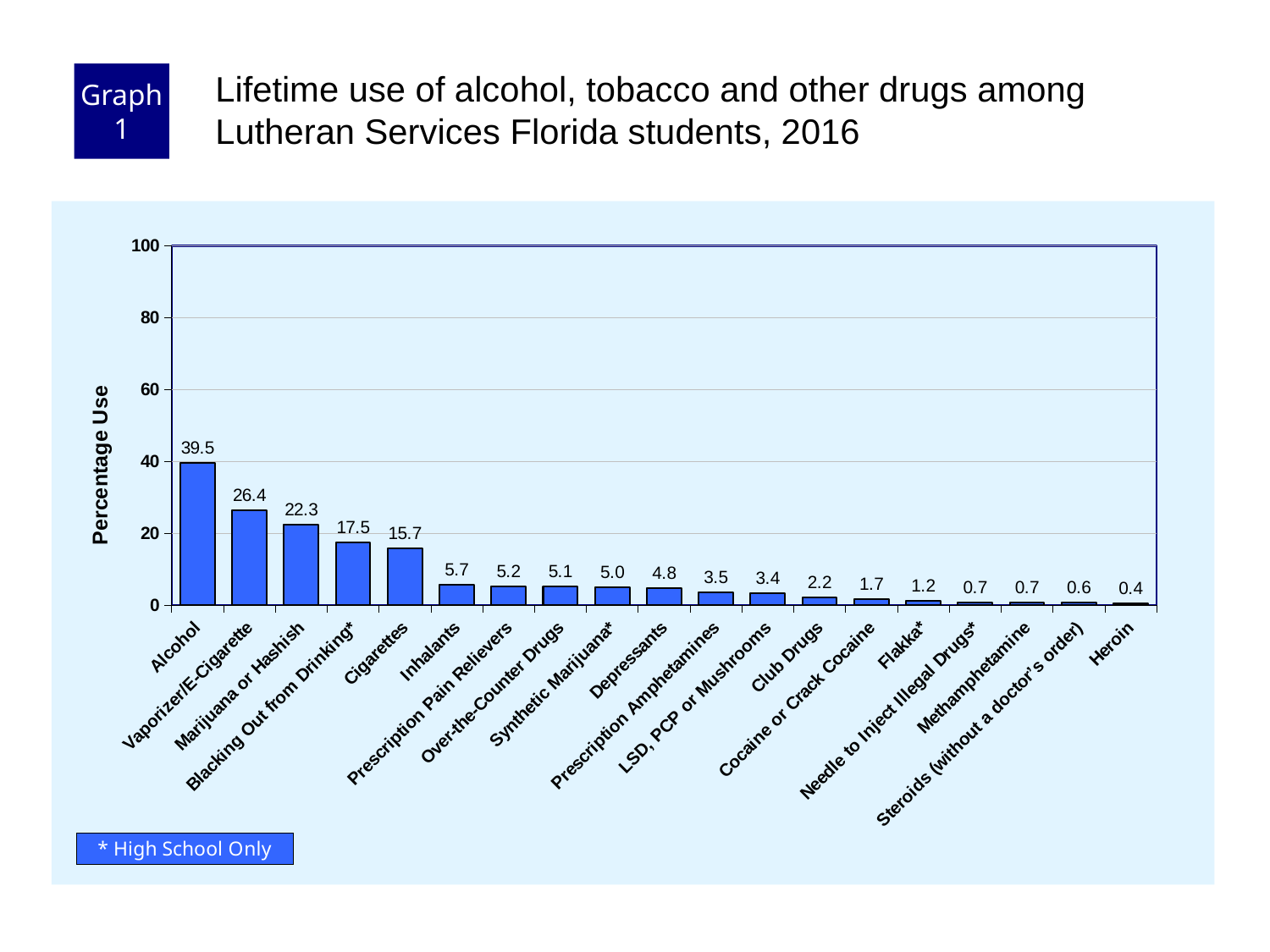
What kind of chart is this? Bar chart Which category has the lowest value? Heroin What is the difference between the values for Marijuana or Hashish and Cigarettes? 6.6 Is the value for Vaporizer/E-Cigarette greater or less than 20? greater How many categories are shown on the x axis? 19 What is the value for Alcohol? 39.5 What is the value for Cigarettes? 15.7 Which is larger, the value for Club Drugs or the value for Flakka*? Club Drugs What is the difference between the values for Alcohol and Vaporizer/E-Cigarette? 13.1 Which category has the highest value? Alcohol What is the value for Inhalants? 5.7 What is the value for Heroin? 0.4